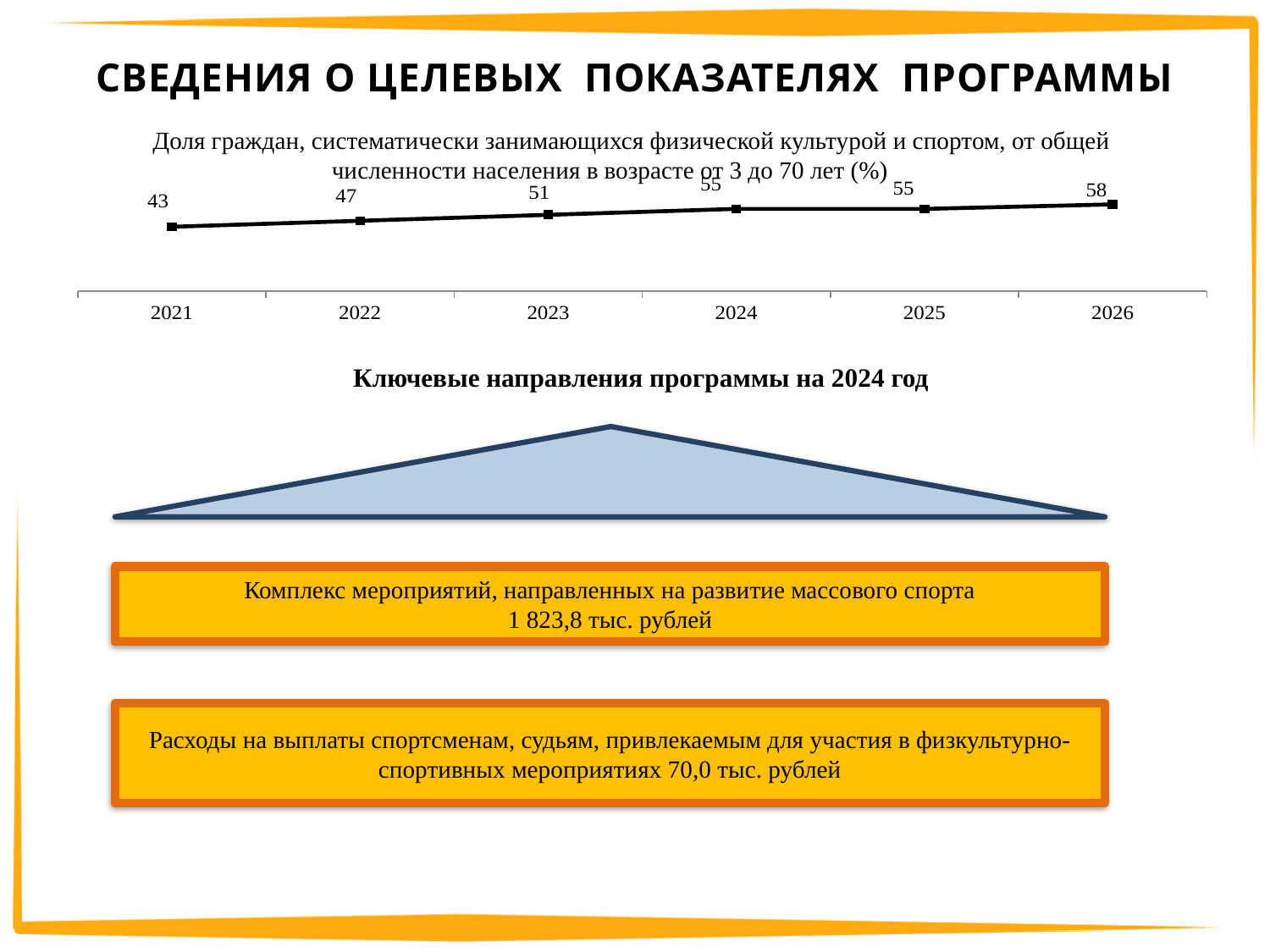
What is the value for 2026 in the line chart? 58 How many years are plotted on the x axis of the line chart? 6 Which two consecutive years in the line chart have the same value? 2024 and 2025 Do the values in the line chart generally rise or fall from 2021 to 2026? rise What is the difference between the values for 2024 and 2022 in the line chart? 8 Which year has the highest value in the line chart? 2026 What kind of chart is shown at the top of the slide? line chart What is the value for 2023 in the line chart? 51 Which is larger in the line chart, the value for 2022 or the value for 2025? 2025 What is the value for 2021 in the line chart? 43 What is the difference between the values for 2026 and 2021 in the line chart? 15 Which year has the lowest value in the line chart? 2021